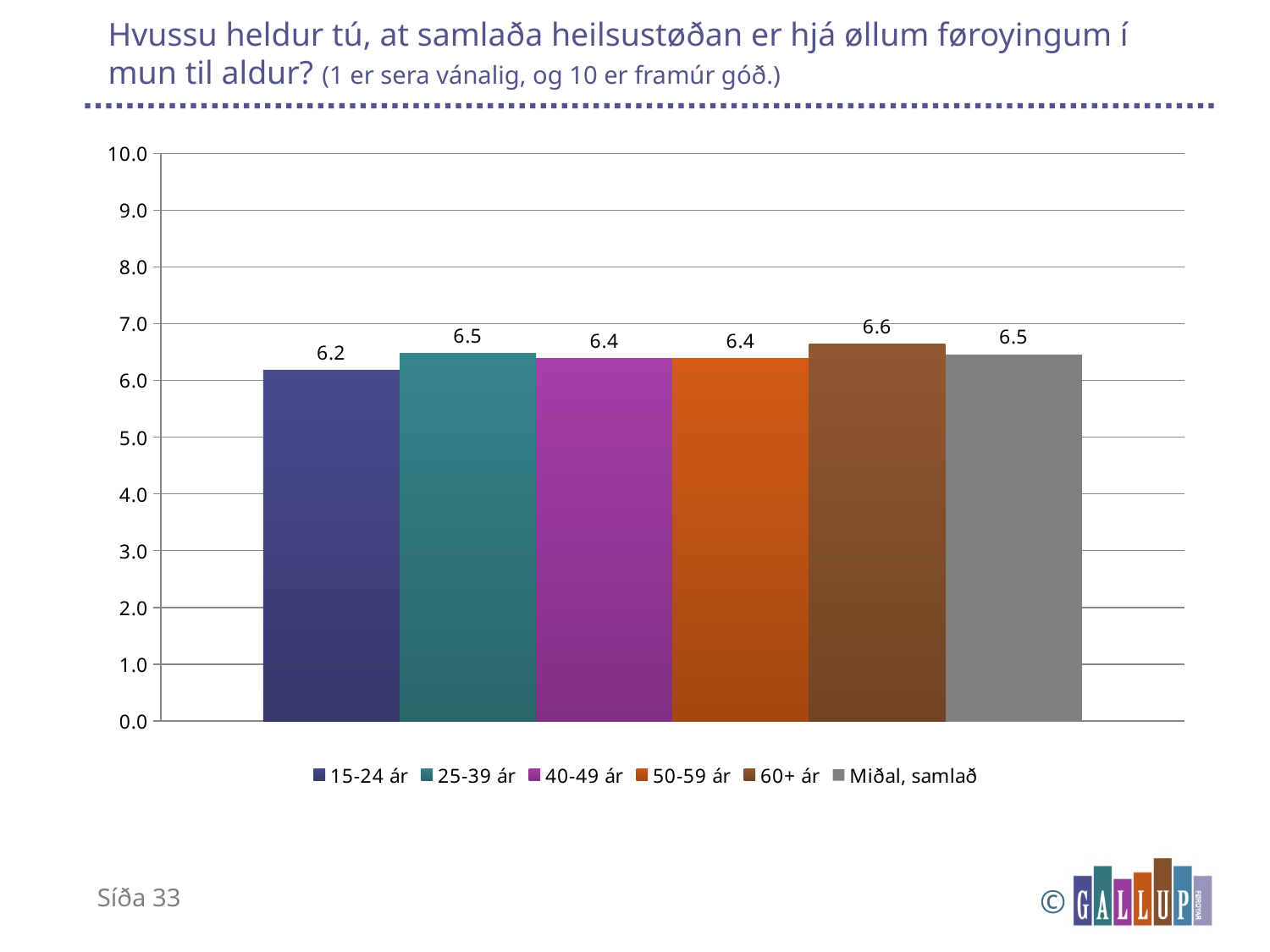
What is the value for 15-24 ár? 6.2 Which age group has the lowest value? 15-24 ár What is the value for Miðal, samlað? 6.5 What is the difference between the values for 60+ ár and 15-24 ár? 0.4 What kind of chart is shown on the slide? bar chart How many bars are plotted in the chart? 6 What is the value for 40-49 ár? 6.4 How many series does the legend list? 6 Which is larger, the value for 25-39 ár or the value for 15-24 ár? 25-39 ár What is the value for 60+ ár? 6.6 Is the value for 60+ ár greater or less than 7.0? less Which age group has the highest value? 60+ ár